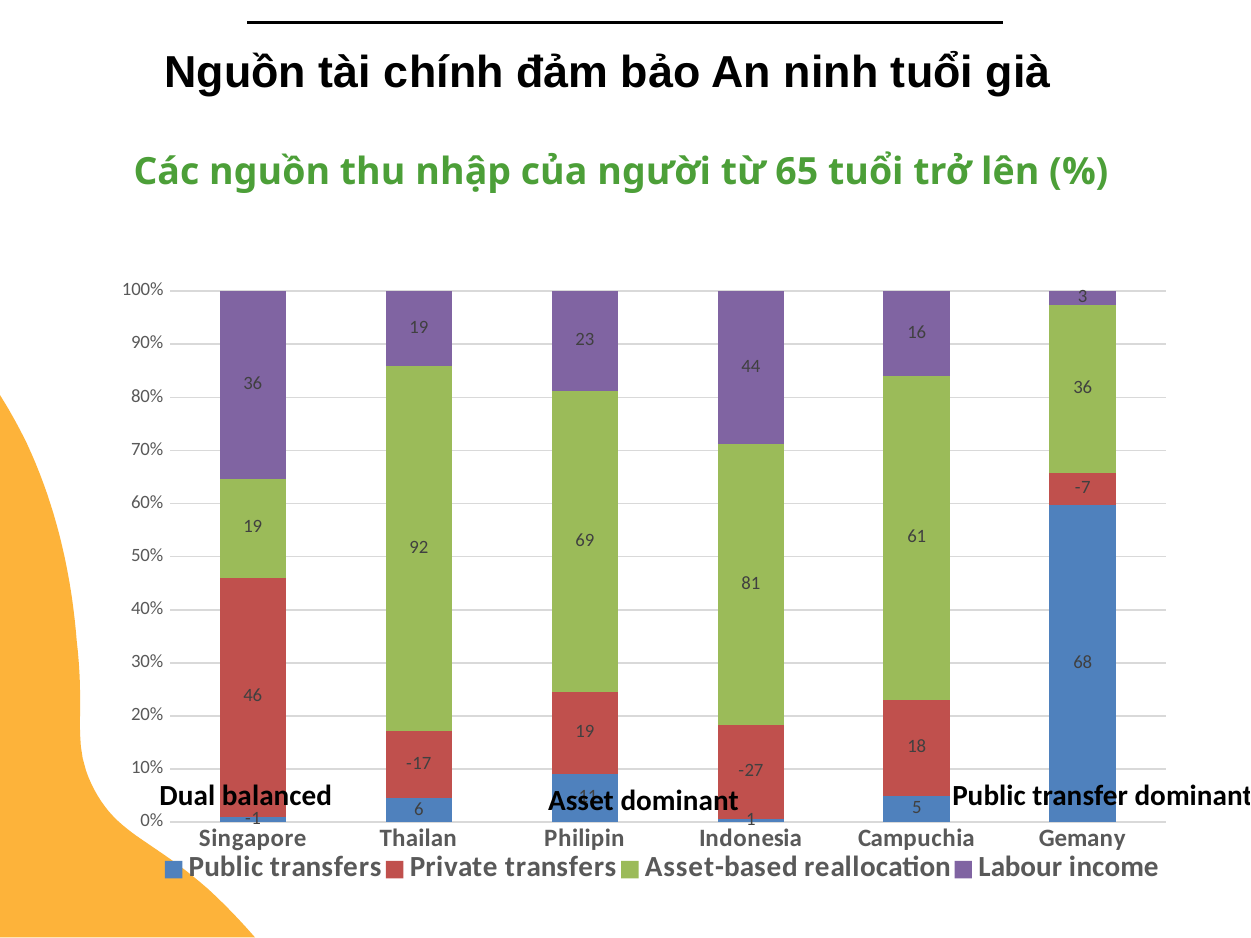
Which country has the highest Asset-based reallocation value? Thailan Which is larger, the Labour income value for Singapore or for Philipin? Singapore How many series does the legend list? 4 What kind of chart is shown on the slide? Stacked bar chart Which colour represents Private transfers in the legend? Red How many countries are shown on the x axis? 6 What is the Labour income value for Indonesia? 44 What is the difference between the Asset-based reallocation values for Indonesia and Campuchia? 20 Which country has the lowest Labour income value? Gemany What is the Asset-based reallocation value for Thailan? 92 What is the Public transfers value for Gemany? 68 What is the Private transfers value for Singapore? 46